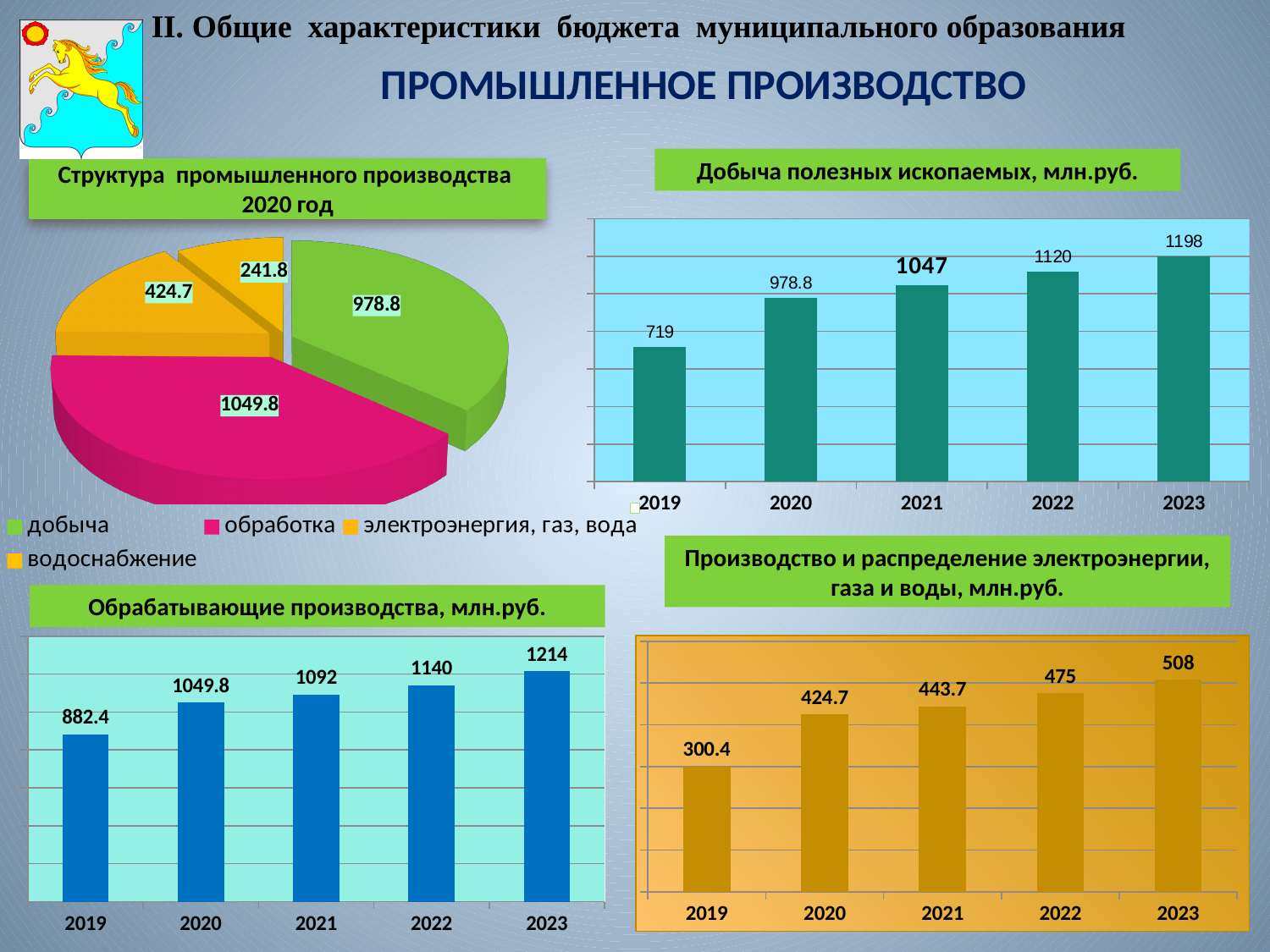
In the pie chart 'Структура промышленного производства 2020 год', which of 'добыча' or 'электроэнергия, газ, вода' has the larger value? добыча In the chart 'Обрабатывающие производства, млн.руб.', do the values rise or fall from 2019 to 2023? rise In the chart 'Обрабатывающие производства, млн.руб.', what is the value for 2021? 1092 In the pie chart 'Структура промышленного производства 2020 год', what is the value for 'обработка'? 1049.8 In the chart 'Производство и распределение электроэнергии, газа и воды, млн.руб.', what is the difference between the 2023 and 2019 values? 207.6 In the chart 'Обрабатывающие производства, млн.руб.', which year has the lowest value? 2019 In the chart 'Производство и распределение электроэнергии, газа и воды, млн.руб.', how many years are shown? 5 In the chart 'Добыча полезных ископаемых, млн.руб.', which year has the highest value? 2023 What kind of chart is 'Обрабатывающие производства, млн.руб.'? bar chart In the chart 'Добыча полезных ископаемых, млн.руб.', what is the value for 2019? 719 In the chart 'Добыча полезных ископаемых, млн.руб.', what is the difference between the 2023 and 2022 values? 78 In the chart 'Производство и распределение электроэнергии, газа и воды, млн.руб.', what is the value for 2022? 475